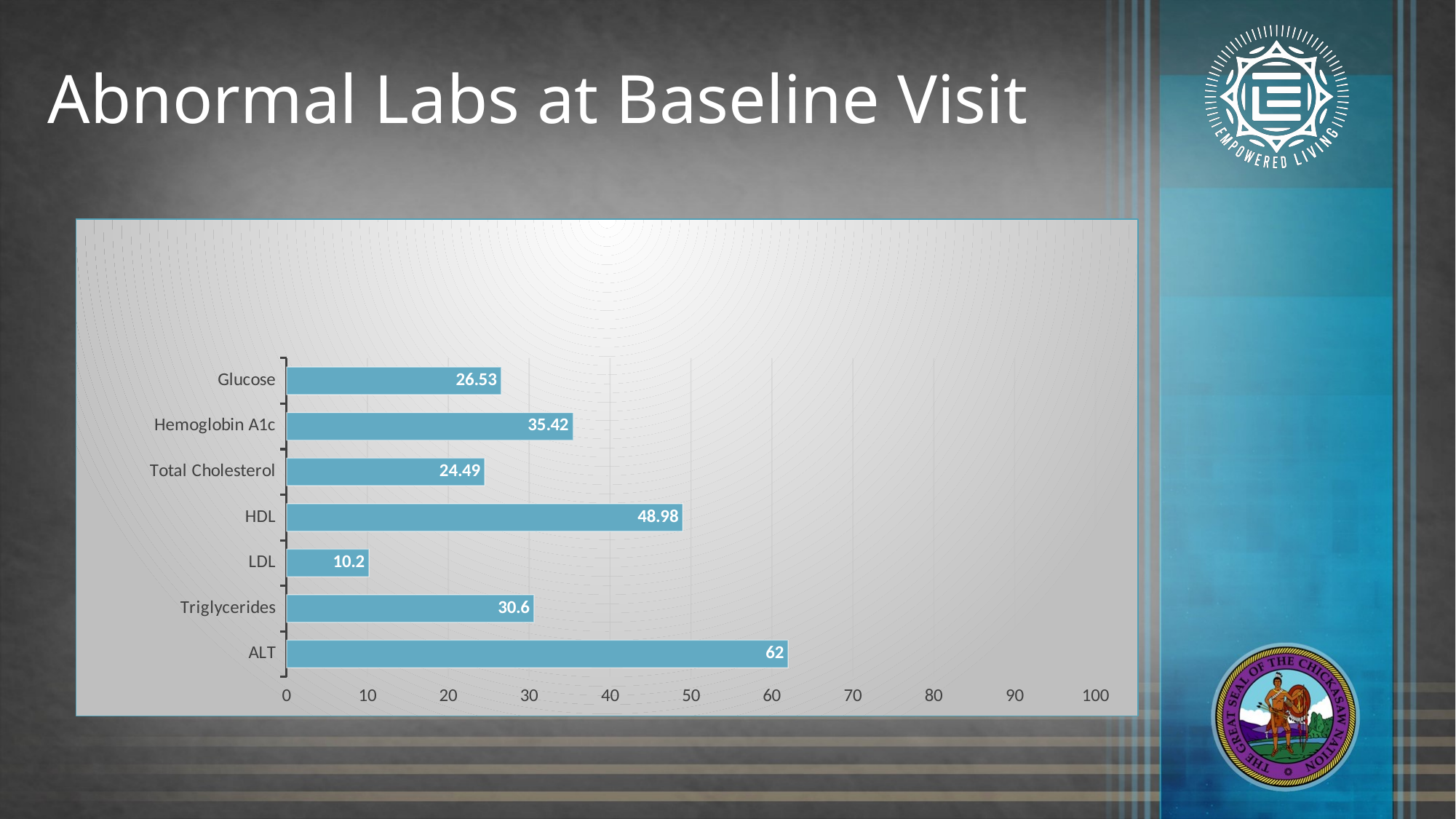
What is the title of the slide containing the chart? Abnormal Labs at Baseline Visit What is the difference between the values for ALT and HDL? 13.02 Which category has the lowest value? LDL What is the value for ALT? 62 What is the difference between the values for Glucose and Total Cholesterol? 2.04 What is the value for LDL? 10.2 Which is larger, the value for Triglycerides or the value for Glucose? Triglycerides Which category has the highest value? ALT What is the value for Hemoglobin A1c? 35.42 What is the value for HDL? 48.98 How many categories are shown in the chart? 7 What kind of chart is shown on the slide? bar chart